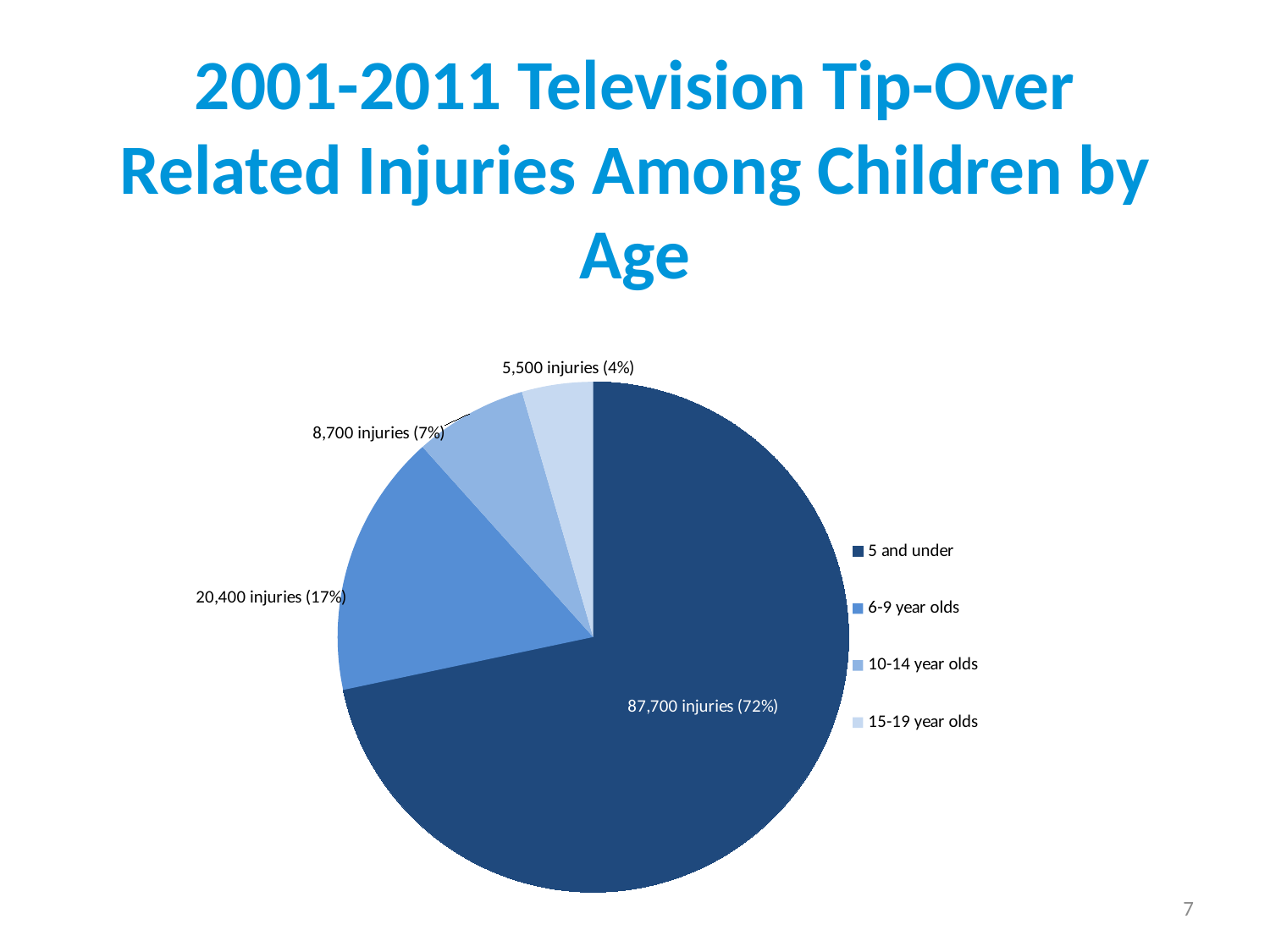
How many age groups does the legend list? 4 Which age group has the smallest slice of the pie? 15-19 year olds What share of the pie does the 5 and under age group represent? 72% Which age group has the largest slice of the pie? 5 and under What kind of chart is shown on the slide? pie chart How many injuries are shown for 15-19 year olds? 5,500 injuries What is the difference in injuries between the 5 and under group and 6-9 year olds? 67,300 injuries How many injuries are shown for the 5 and under age group? 87,700 injuries How many injuries are shown for 10-14 year olds? 8,700 injuries What share of the pie do 6-9 year olds represent? 17% Which group has more injuries, 10-14 year olds or 15-19 year olds? 10-14 year olds How many injuries are shown for 6-9 year olds? 20,400 injuries